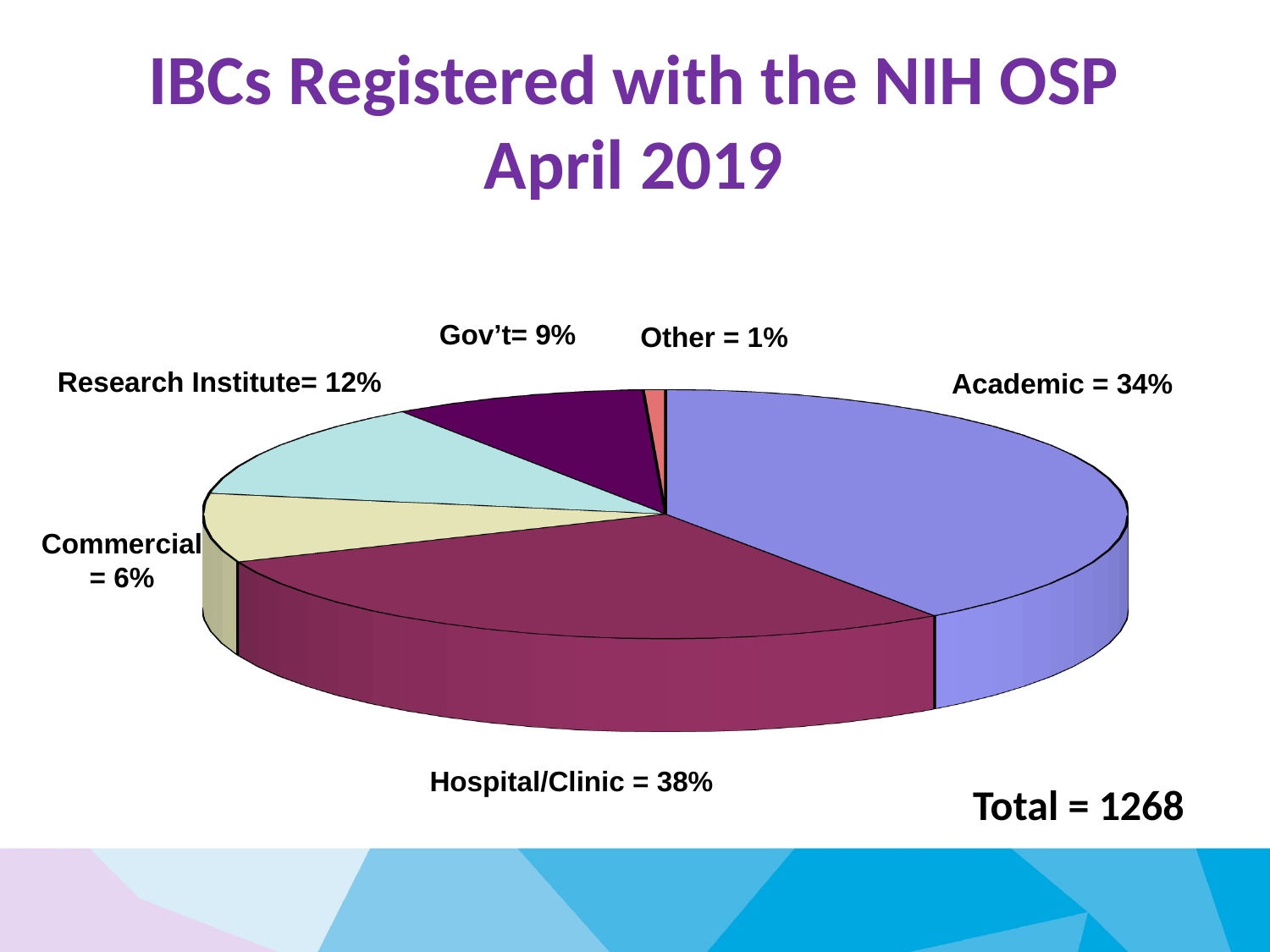
What total number of IBCs is stated on the slide? 1268 What share of IBCs registered with the NIH OSP are Academic? 34% Which category has the smallest share of the pie? Other What percentage is shown for Commercial? 6% What percentage is shown for Research Institute? 12% What share of IBCs are Hospital/Clinic? 38% Which category has the largest share of the pie? Hospital/Clinic Which is larger, the Research Institute share or the Gov't share? Research Institute How many categories are shown in the pie chart? 6 What is the difference in percentage points between Hospital/Clinic and Academic? 4 What percentage is shown for Gov't? 9% What kind of chart is shown on the slide? pie chart